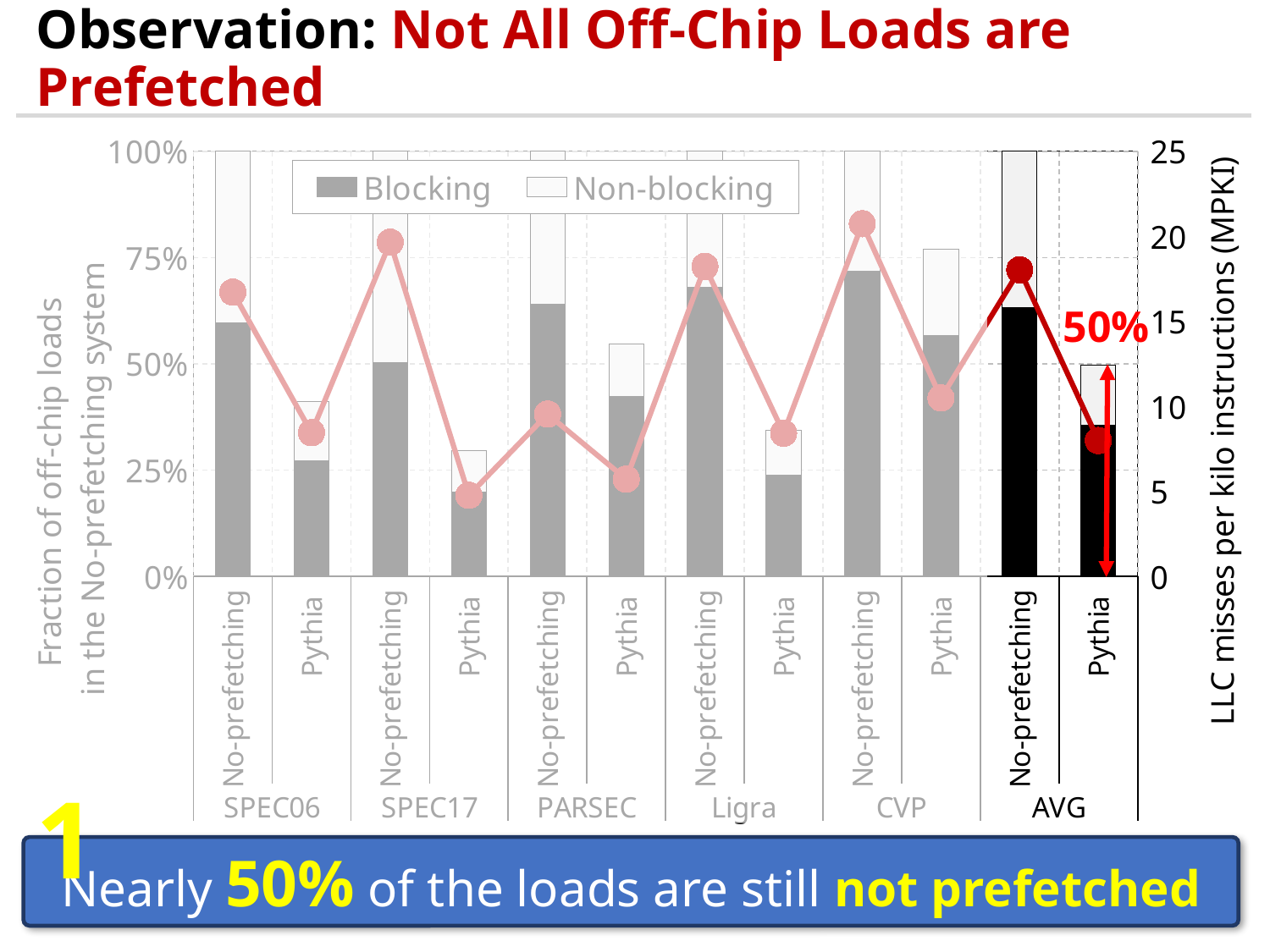
How many bars are plotted in total? 12 Is the MPKI line value for No-prefetching in SPEC17 greater or less than 15? greater What is the total height of the No-prefetching bar in the AVG group? 100% Among the Pythia bars, which benchmark group has the tallest stacked bar? CVP What is the total height of the Pythia bar in the AVG group, as annotated on the chart? 50% What is the label of the right-hand y axis? LLC misses per kilo instructions (MPKI) Is the Blocking portion of the Pythia bar for SPEC17 greater or less than 25%? less How many benchmark groups are shown along the x axis? 6 Is the Blocking portion of the No-prefetching bar for SPEC06 greater or less than 50%? greater What are the two series named in the legend? Blocking and Non-blocking How many series does the legend list? 2 What kind of chart is shown on the slide? Stacked bar chart with a line overlay